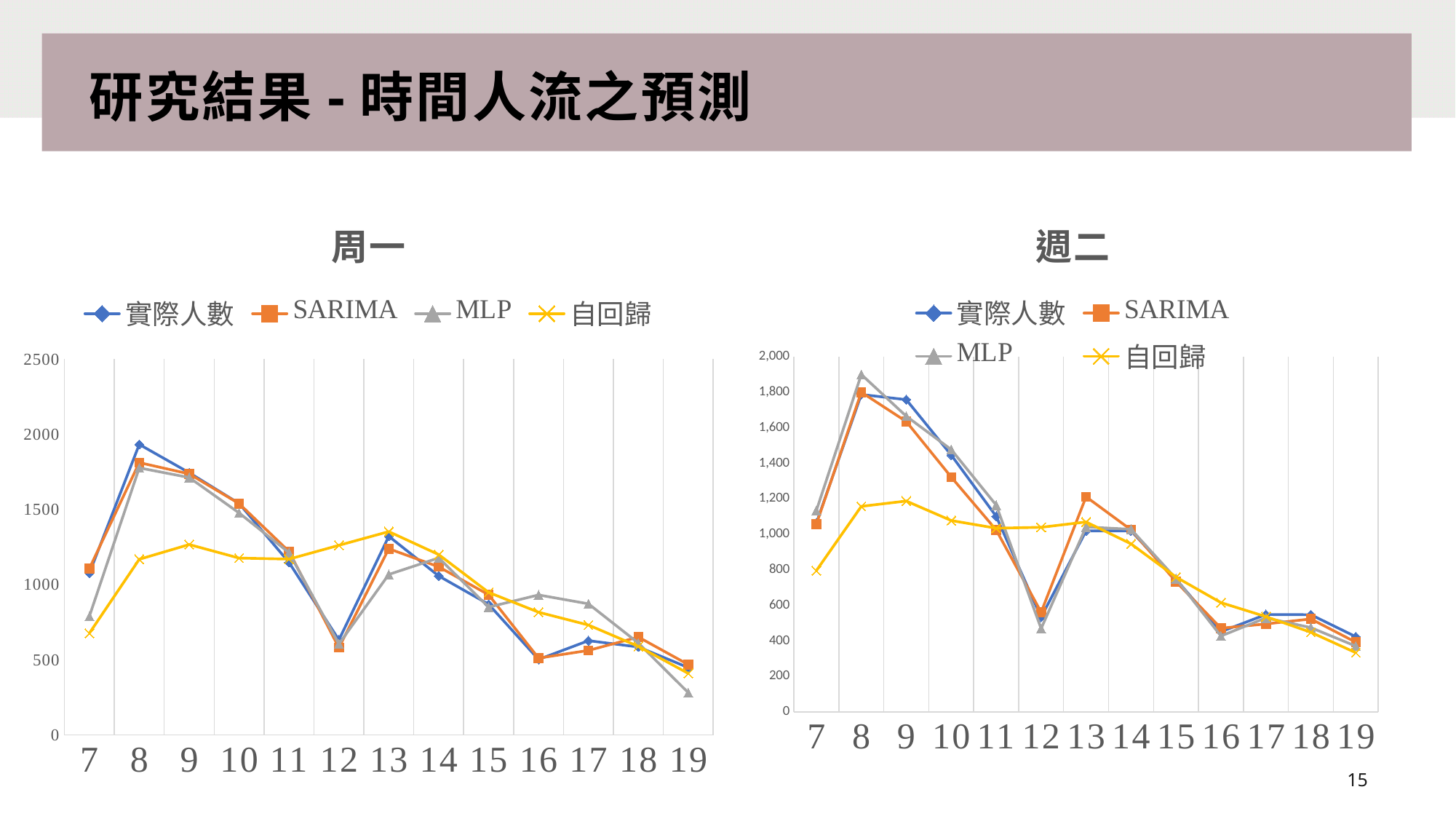
How many x-axis categories (hours) are plotted on the 周一 chart? 13 On the 周一 chart, at which hour is MLP at its lowest value? 19 On the 周一 chart, is the value of 自回歸 at 7 greater or less than 1000? less On the 周一 chart, at which hour does 實際人數 reach its highest value? 8 On the 週二 chart, at hour 13, which is larger: SARIMA or MLP? SARIMA What kind of chart is the 周一 chart? line chart On the 週二 chart, is the value of MLP at 8 greater or less than 1,800? greater How many series does the legend of the 週二 chart list? 4 What is the title of the chart on the right side of the slide? 週二 On the 周一 chart, is the value of 實際人數 at 8 greater or less than 1500? greater On the 週二 chart, does 實際人數 rise or fall from hour 9 to hour 12? fall